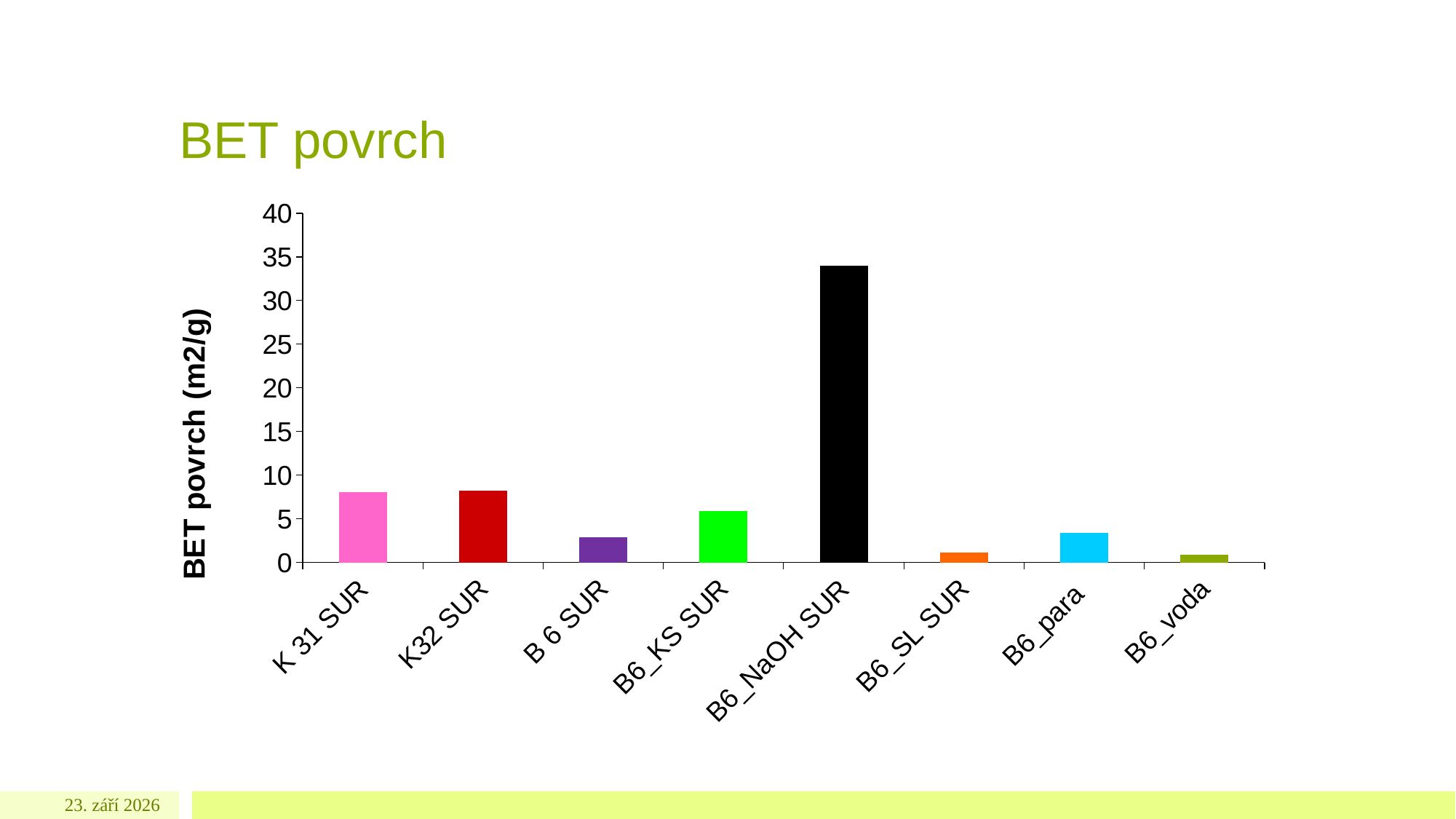
Is the value for B6_KS SUR greater or less than 5? greater What kind of chart is shown on the slide? bar chart How many categories are plotted on the x axis? 8 Is the value for K 31 SUR greater or less than 10? less What is the title of the y axis? BET povrch (m2/g) Is the value for B6_para greater or less than 5? less Which is larger, the value for B6_NaOH SUR or the value for K32 SUR? B6_NaOH SUR Which is larger, the value for B6_KS SUR or the value for B 6 SUR? B6_KS SUR What colour is the bar for B6_NaOH SUR? black Which category has the highest BET povrch value? B6_NaOH SUR